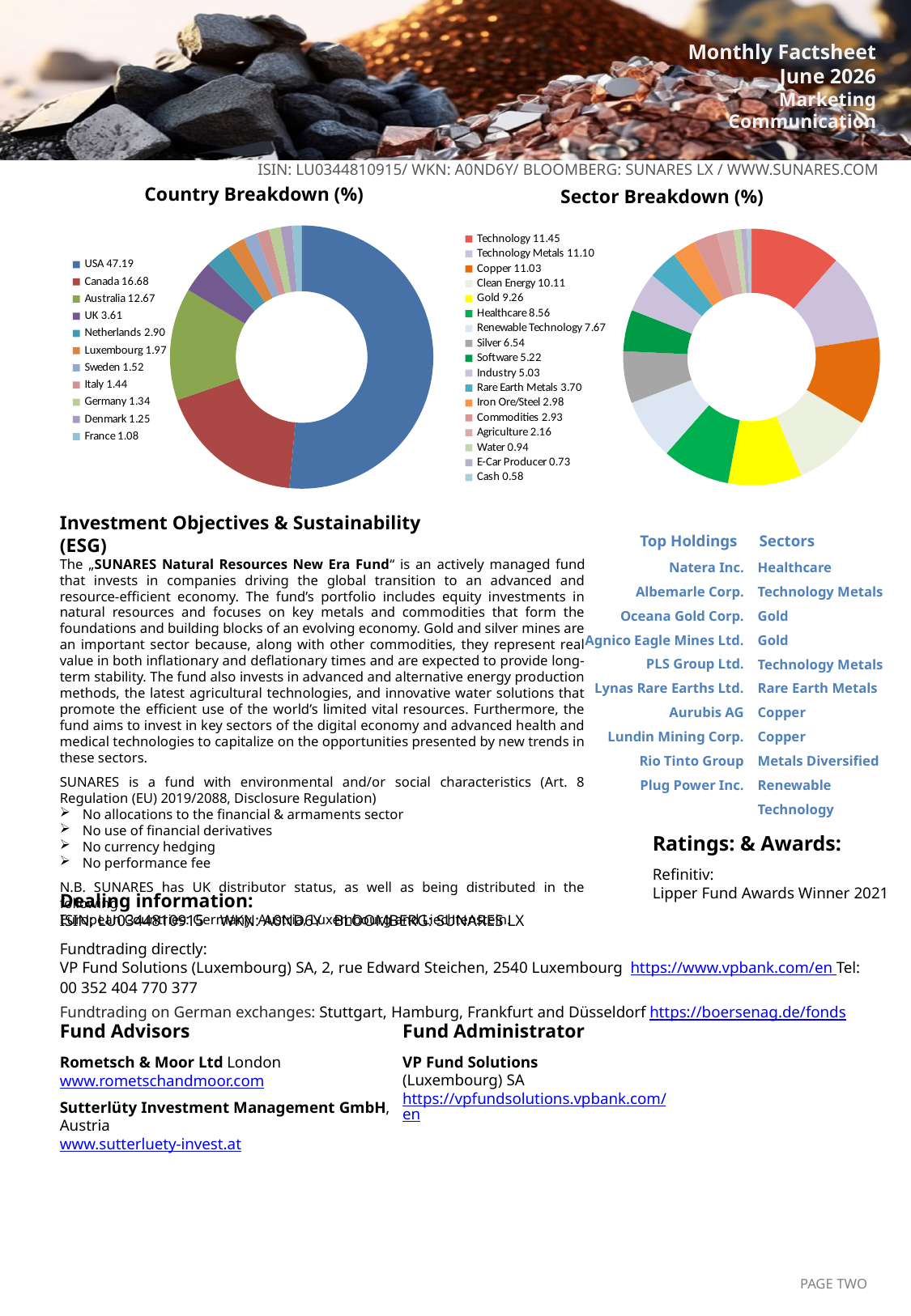
In the Country Breakdown (%) chart, which country has the smallest share? France In the Country Breakdown (%) chart, what is the value for Canada? 16.68 In the Country Breakdown (%) chart, which country has the largest share? USA In the Sector Breakdown (%) chart, what is the difference between the values for Healthcare and Renewable Technology? 0.89 In the Sector Breakdown (%) chart, which is larger: Silver or Software? Silver In the Sector Breakdown (%) chart, which sector has the smallest share? Cash How many sectors are listed in the Sector Breakdown (%) chart? 17 How many countries are shown in the Country Breakdown (%) chart? 11 In the Sector Breakdown (%) chart, which sector has the largest share? Technology In the Country Breakdown (%) chart, what is the difference between the values for USA and Canada? 30.51 In the Sector Breakdown (%) chart, what is the value for Gold? 9.26 What type of chart is the Country Breakdown (%) chart? Pie (donut) chart